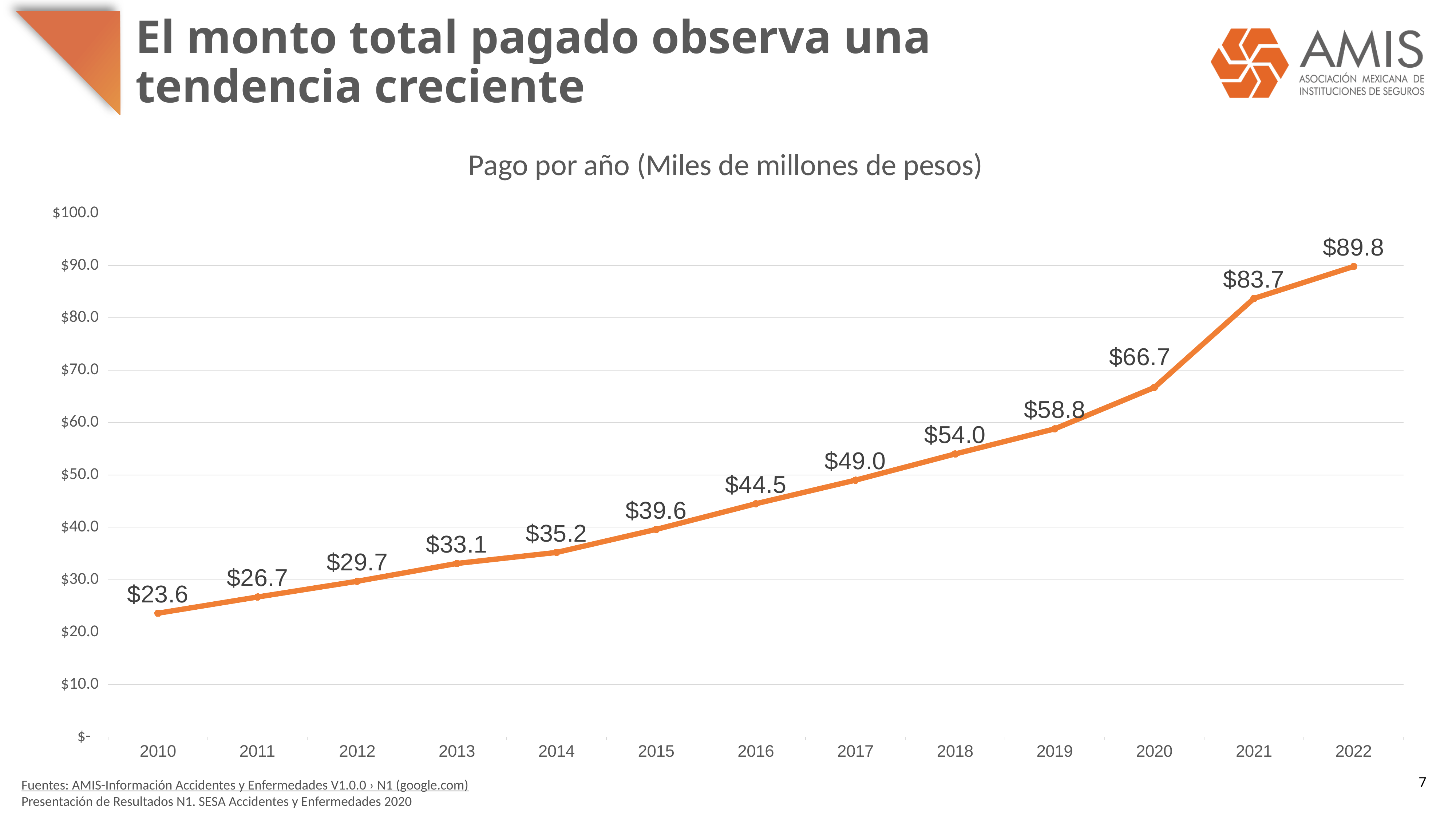
What is the value for 2016? $44.5 Which year has the highest value? 2022 What is the difference between the values for 2022 and 2021? $6.1 What is the difference between the values for 2020 and 2019? $7.9 Which year has the lowest value? 2010 What kind of chart is shown? line chart Do the values rise or fall from 2010 to 2022? rise How many years are plotted on the chart? 13 What is the value for 2021? $83.7 Is the value for 2018 greater or less than $50.0? greater Which is larger, the value for 2014 or the value for 2015? 2015 What is the value for 2010? $23.6